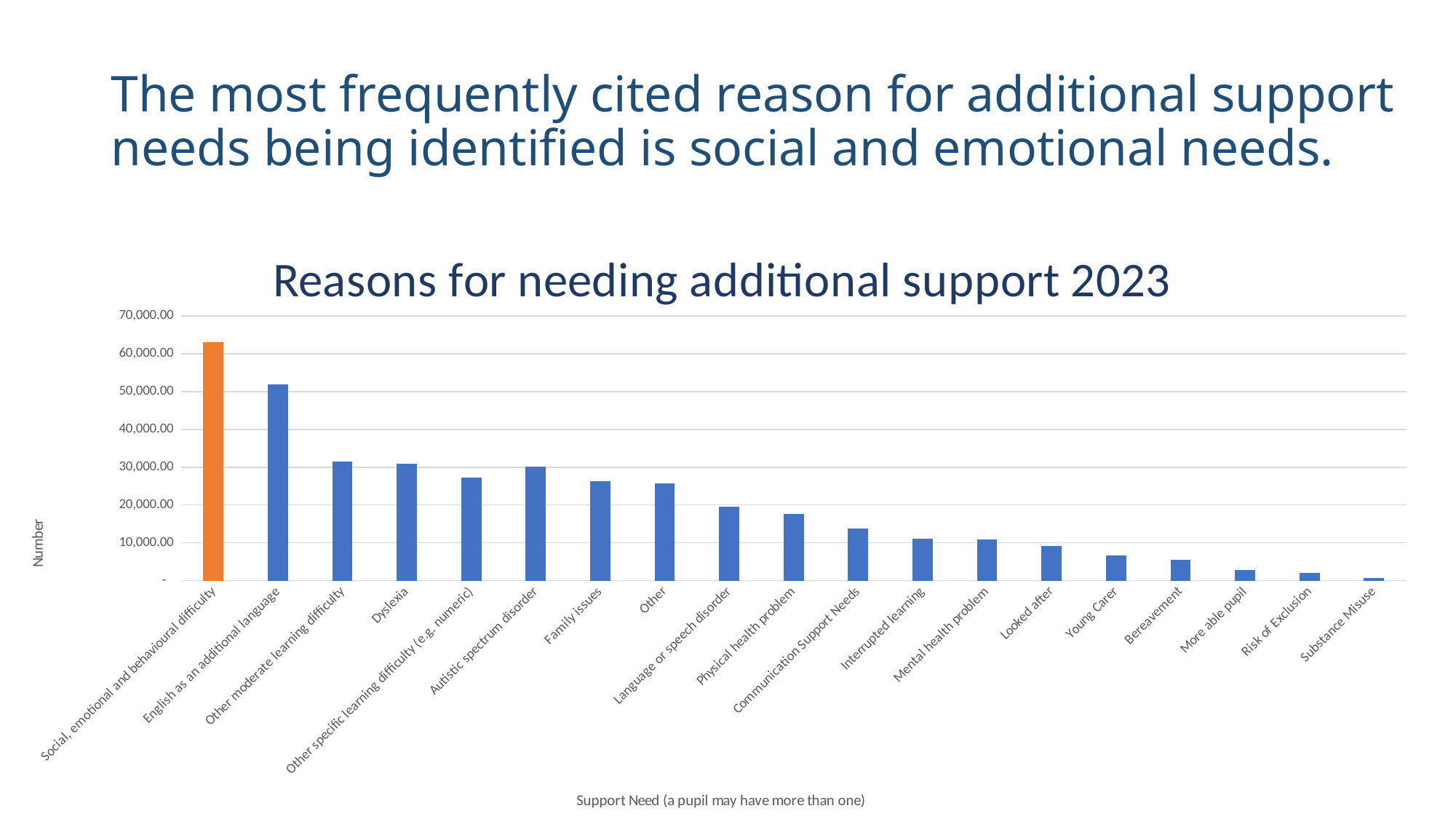
Which is larger, the value for Family issues or the value for Looked after? Family issues What kind of chart is shown on the slide? Bar chart What is the title of the chart? Reasons for needing additional support 2023 Which support need has the lowest number? Substance Misuse Is the value for Physical health problem greater or less than 20,000.00? less Is the value for Social, emotional and behavioural difficulty greater or less than 60,000.00? greater Do the values generally rise or fall moving from left to right along the x axis? Fall How many support need categories are plotted in the chart? 19 Which bar is coloured orange rather than blue? Social, emotional and behavioural difficulty Is the value for English as an additional language greater or less than 50,000.00? greater Which support need has the highest number? Social, emotional and behavioural difficulty